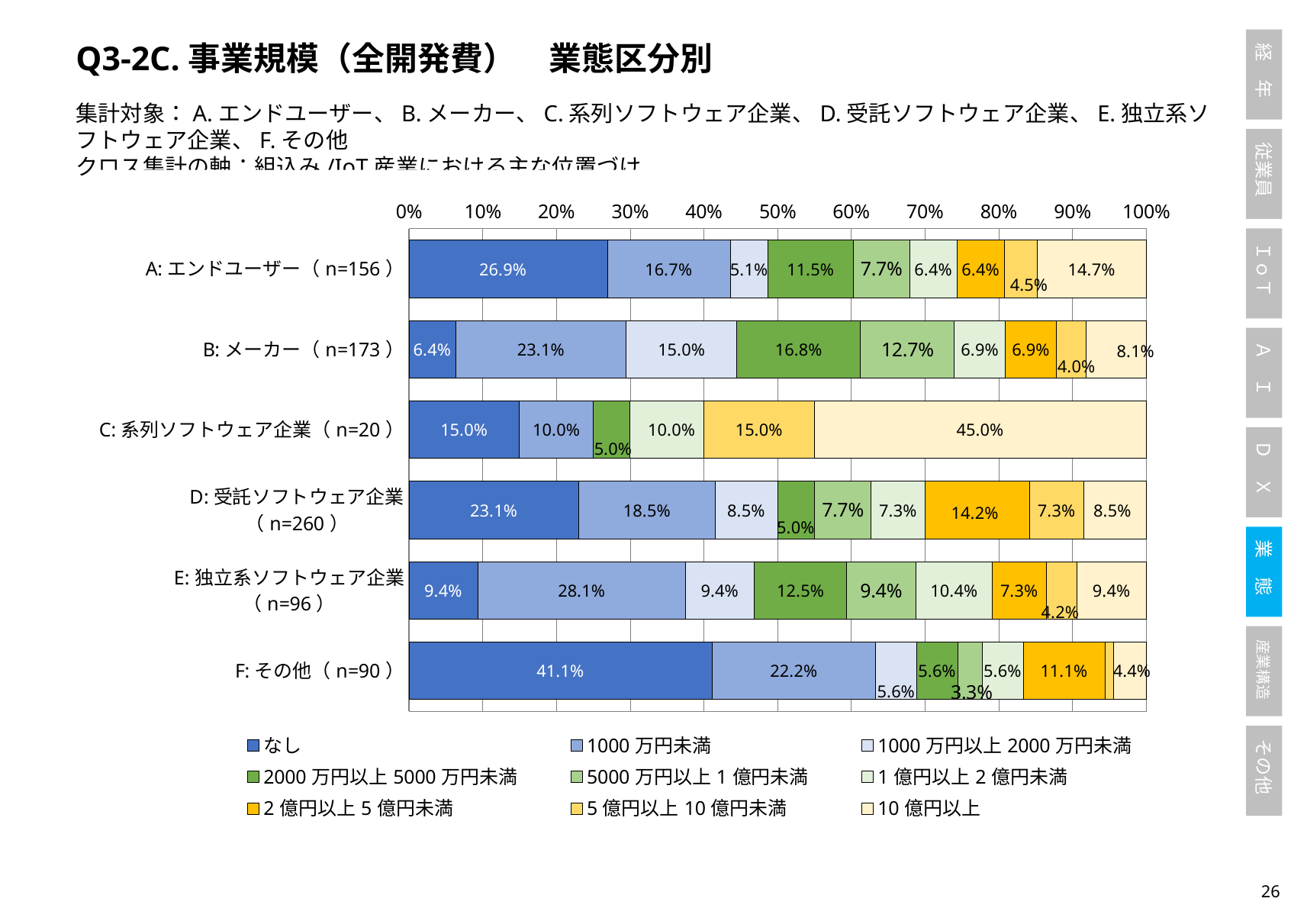
How many business-type categories (bars) are plotted in the chart? 6 What kind of chart is shown on the slide? Stacked bar chart How many series does the legend list? 9 What is the value of the 1000 万円未満 segment for E: 独立系ソフトウェア企業 (n=96)? 28.1% What is the sample size (n) shown for B: メーカー? 173 Which category has the highest value for the なし segment? F: その他 (n=90) Which has the larger なし segment, A: エンドユーザー or B: メーカー? A: エンドユーザー What is the value of the 2 億円以上 5 億円未満 segment for D: 受託ソフトウェア企業 (n=260)? 14.2% What is the value of the 10 億円以上 segment for C: 系列ソフトウェア企業 (n=20)? 45.0% Which category has the lowest value for the なし segment? B: メーカー (n=173) What is the value of the なし segment for F: その他 (n=90)? 41.1% What is the difference between the なし values for F: その他 (41.1%) and A: エンドユーザー (26.9%)? 14.2 percentage points